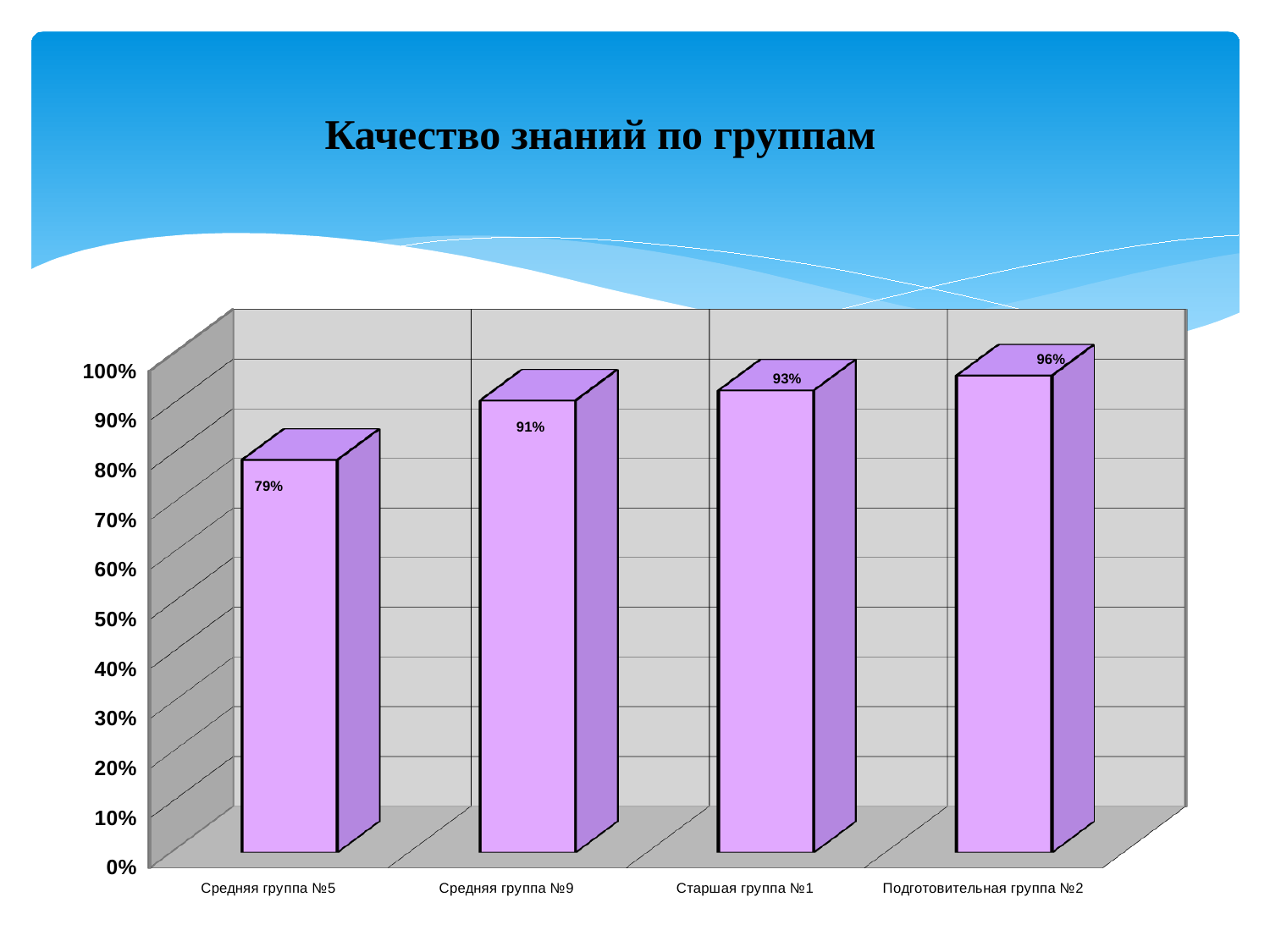
What is the value for Подготовительная группа №2? 96% Do the values rise or fall from left to right along the x axis? Rise What is the difference between the values for Старшая группа №1 and Средняя группа №9? 2% What is the difference between the values for Подготовительная группа №2 and Средняя группа №5? 17% Which is larger, the value for Средняя группа №9 or the value for Средняя группа №5? Средняя группа №9 What kind of chart is shown on the slide? Bar chart What is the value for Средняя группа №5? 79% What is the value for Старшая группа №1? 93% What is the value for Средняя группа №9? 91% Which group has the highest value? Подготовительная группа №2 How many groups are shown on the chart? 4 Which group has the lowest value? Средняя группа №5